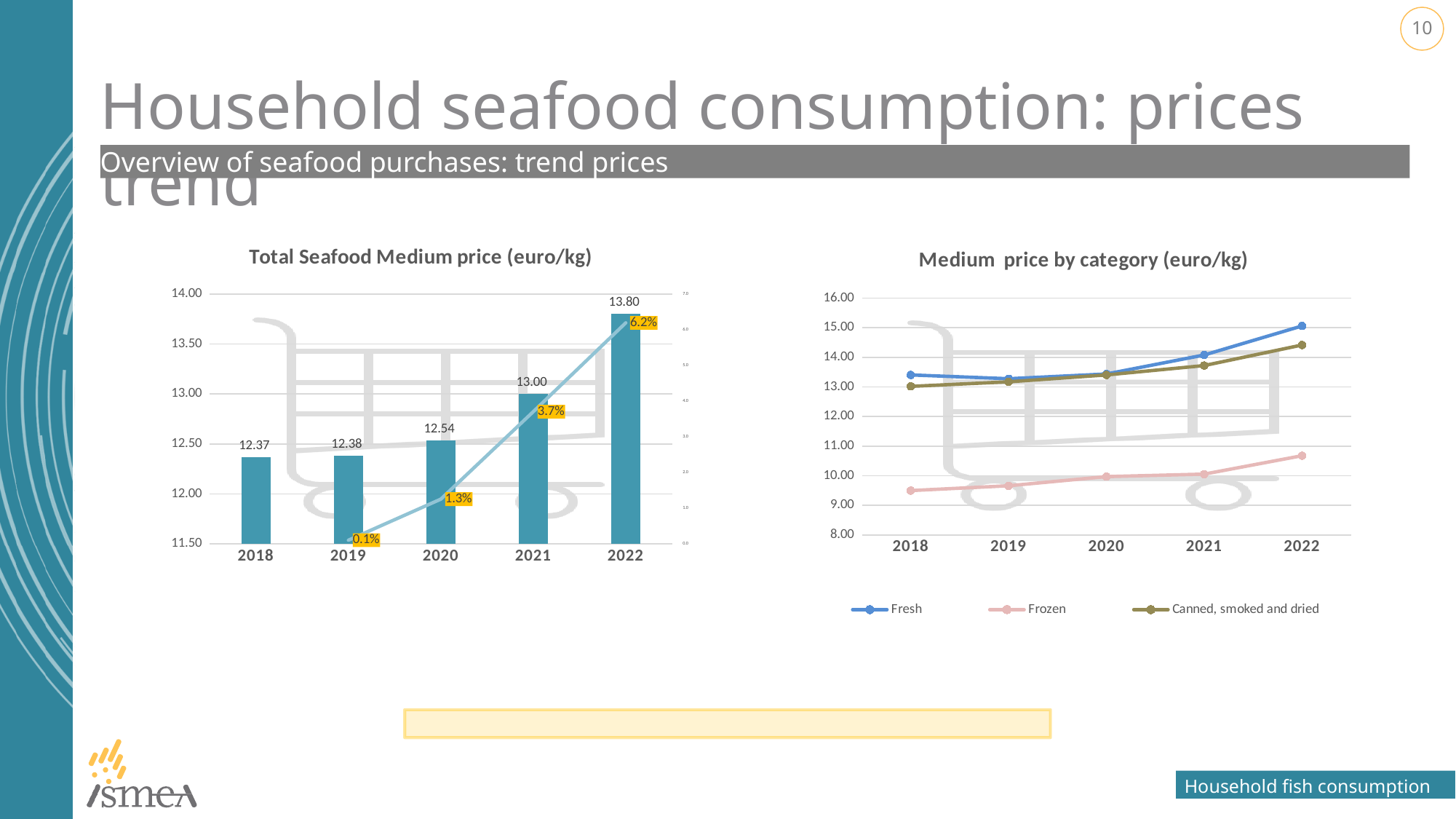
In the 'Total Seafood Medium price (euro/kg)' chart, do the bar values rise or fall from 2018 to 2022? rise In the 'Total Seafood Medium price (euro/kg)' chart, what is the difference between the 2022 and 2021 values? 0.80 In the 'Medium price by category (euro/kg)' chart, is the value for Frozen in 2018 greater or less than 10.00? less What kind of chart is 'Medium price by category (euro/kg)'? line chart In the 'Total Seafood Medium price (euro/kg)' chart, what is the value for 2022? 13.80 In the 'Medium price by category (euro/kg)' chart, which category has the lowest price in 2022? Frozen How many series does the legend of the 'Medium price by category (euro/kg)' chart list? 3 In the 'Total Seafood Medium price (euro/kg)' chart, what percentage change label is shown for 2021? 3.7% In the 'Total Seafood Medium price (euro/kg)' chart, how many years are shown on the x axis? 5 In the 'Total Seafood Medium price (euro/kg)' chart, what is the value for 2018? 12.37 In the 'Total Seafood Medium price (euro/kg)' chart, which year has the highest medium price? 2022